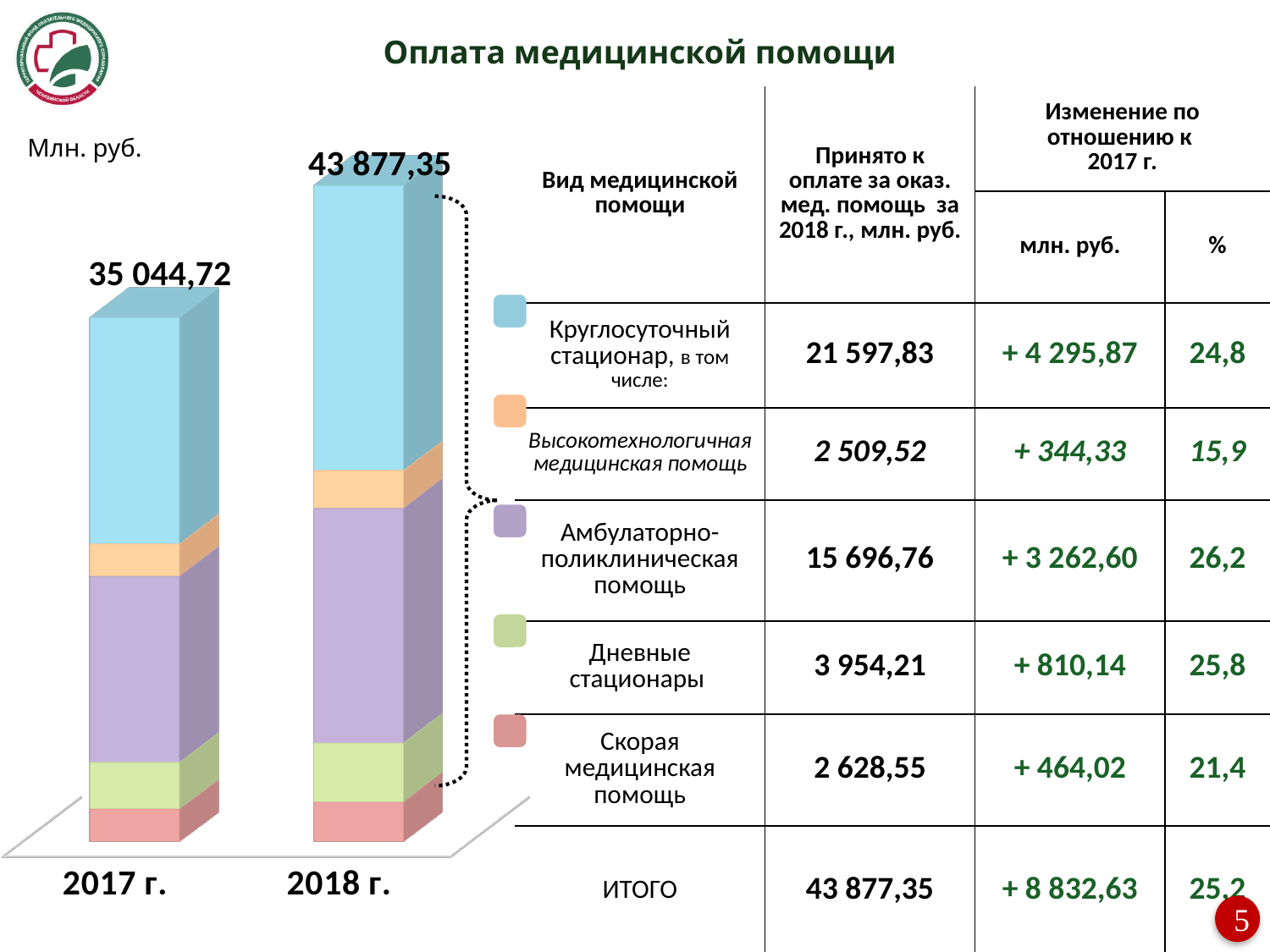
According to the table, what is the 2018 value for Амбулаторно-поликлиническая помощь (the purple segment)? 15 696,76 What unit is the chart measured in, as stated in the top-left corner? Млн. руб. How many bars (years) are shown in the chart? 2 What kind of chart is shown on the slide? Stacked bar chart Which year has the lowest total bar? 2017 г. How many colour-coded segments (types of medical care) does the chart's legend list? 5 What is the total value shown for 2017 г.? 35 044,72 What is the total value shown for 2018 г.? 43 877,35 What is the difference between the 2018 г. total and the 2017 г. total? 8 832,63 According to the table, what is the 2018 value for Скорая медицинская помощь (the red segment)? 2 628,55 Does the total value rise or fall from 2017 г. to 2018 г.? Rise Which year has the higher total bar, 2017 г. or 2018 г.? 2018 г.